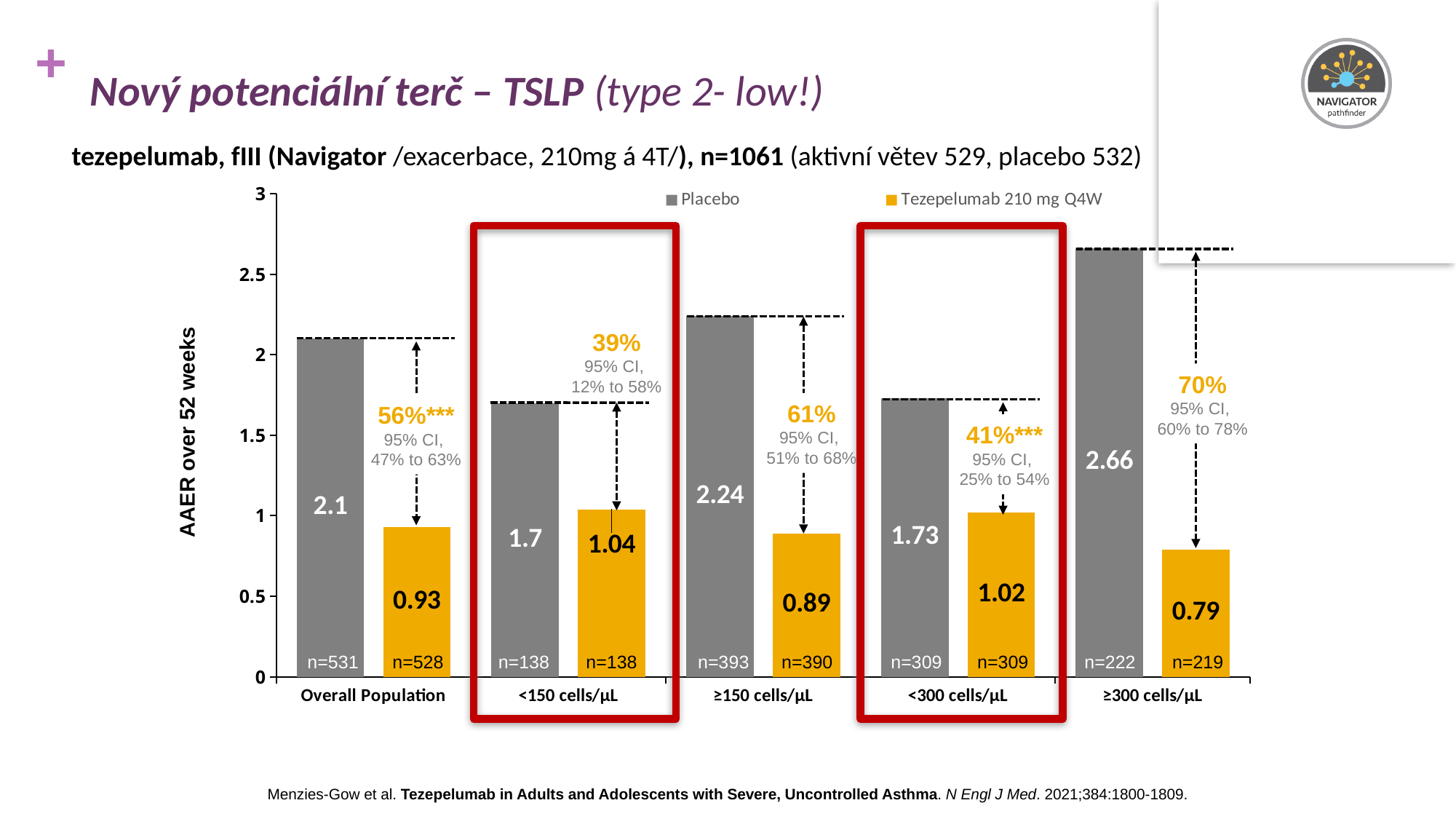
What is the placebo AAER over 52 weeks for the <300 cells/µL group? 1.73 How many series does the legend list? 2 What is the difference between the placebo and Tezepelumab AAER values in the ≥150 cells/µL group? 1.35 Which category has the lowest Tezepelumab 210 mg Q4W AAER over 52 weeks? ≥300 cells/µL What is the label of the y axis? AAER over 52 weeks What percentage reduction is shown for the Overall Population? 56%*** How many categories are shown on the x axis of the chart? 5 Which category has the highest placebo AAER over 52 weeks? ≥300 cells/µL What is the Tezepelumab 210 mg Q4W AAER over 52 weeks for the ≥300 cells/µL group? 0.79 In the <150 cells/µL group, which is larger: the placebo AAER or the Tezepelumab AAER? Placebo What is the placebo AAER over 52 weeks for the Overall Population? 2.1 What kind of chart is shown on the slide? Bar chart